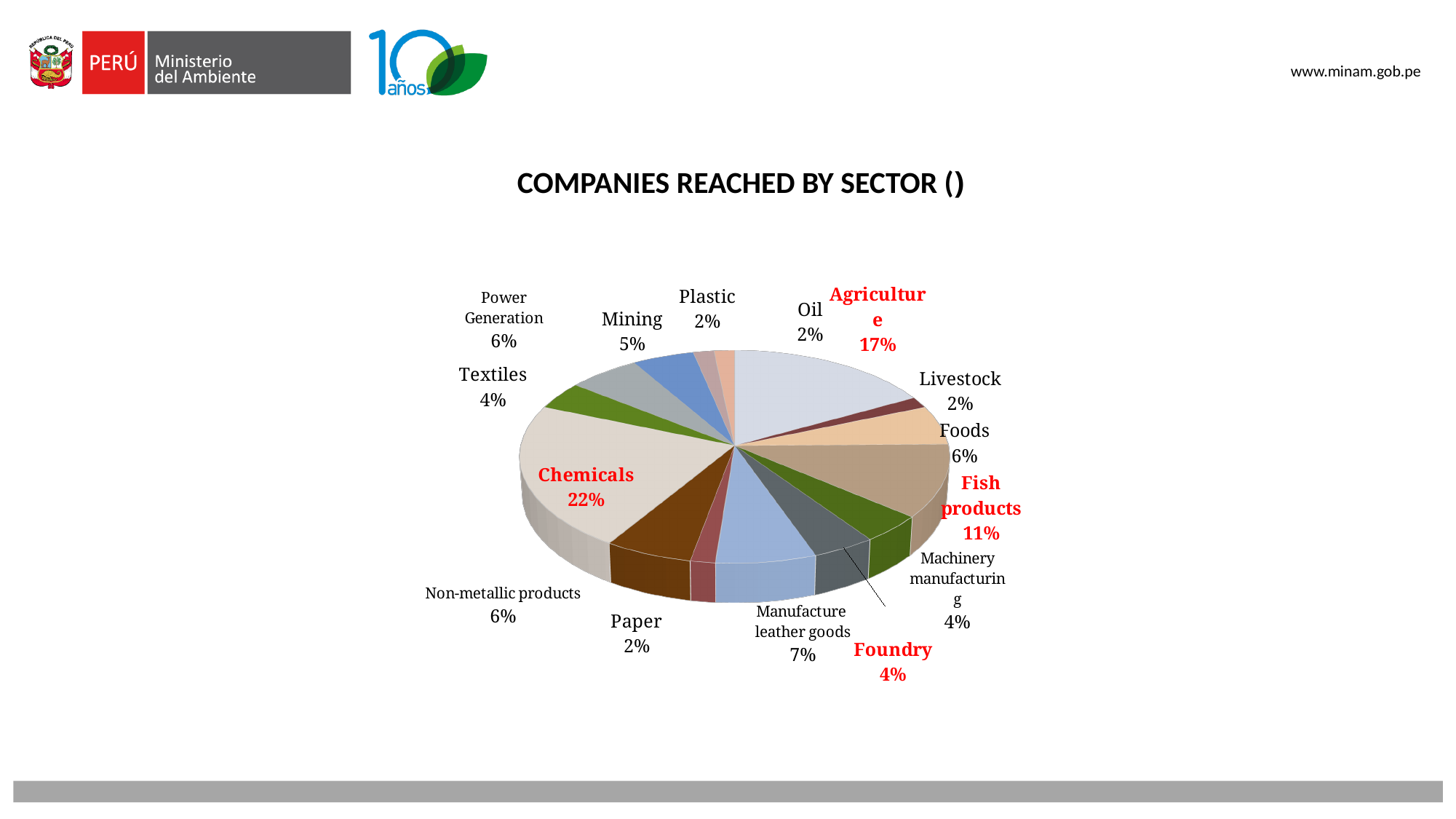
Which is larger, the share for Foods or the share for Textiles? Foods What is the percentage for Manufacture leather goods? 7% What percentage of companies reached are in the Chemicals sector? 22% What is the percentage for Fish products? 11% What is the title of the chart? COMPANIES REACHED BY SECTOR () Which sector labels are highlighted in red on the chart? Agriculture, Fish products, Foundry, Chemicals What is the percentage for Mining? 5% What kind of chart is shown on the slide? Pie chart What is the difference in percentage points between Chemicals and Agriculture? 5 percentage points How many sectors are shown in the pie chart? 15 Which sector has the largest share of companies reached? Chemicals What share of the pie does Agriculture represent? 17%